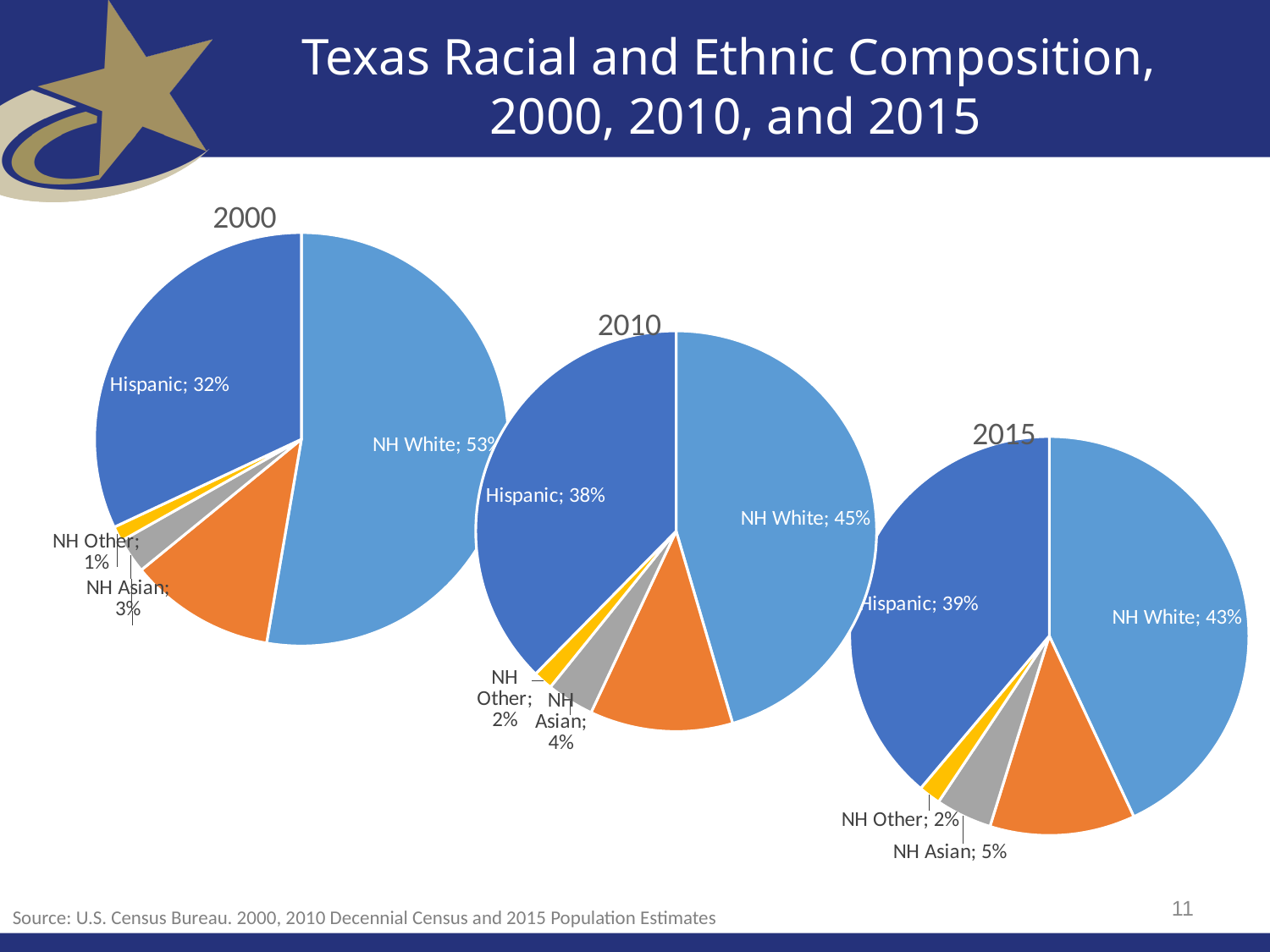
In the 2015 pie chart, which is larger, the Hispanic share or the NH White share? NH White In the 2010 pie chart, which labeled category has the smallest share? NH Other How many pie charts are shown on the slide? 3 In the 2015 pie chart, what share is labeled for NH Asian? 5% In the 2000 pie chart, which labeled category has the largest share? NH White What is the difference between the NH White share in 2000 and the NH White share in 2015? 10% In the 2000 pie chart, what share is labeled for NH White? 53% In the 2015 pie chart, what share is labeled for NH Other? 2% How many slices does the 2010 pie chart have? 5 What kind of chart is used to show the 2000 composition? Pie chart Across the 2000, 2010, and 2015 pie charts, does the Hispanic share rise or fall over time? Rise In the 2010 pie chart, what share is labeled for Hispanic? 38%